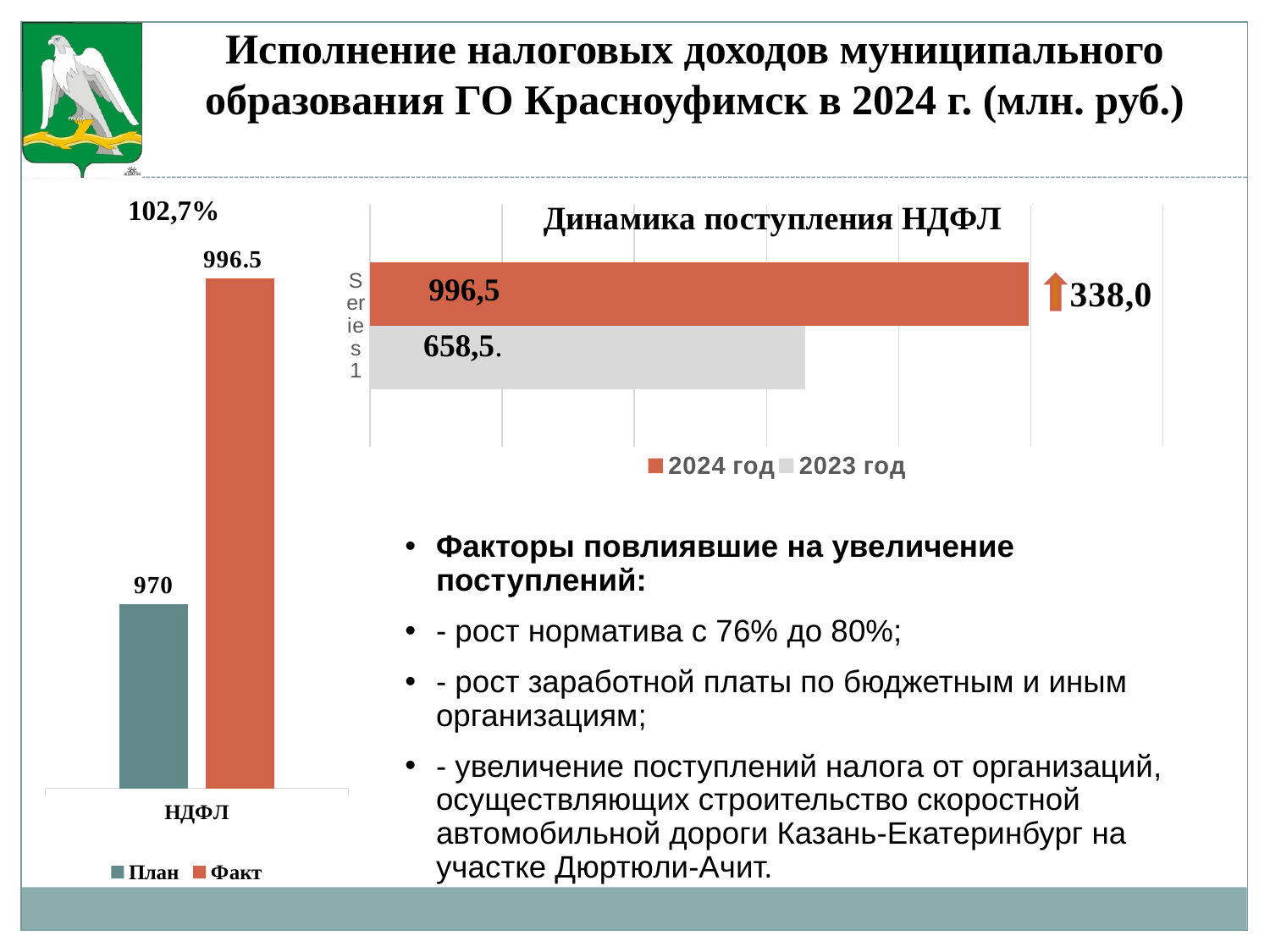
In the chart titled 'Динамика поступления НДФЛ', what is the difference between the 2024 год and 2023 год values? 338,0 In the left chart, what is the value of the План bar for НДФЛ? 970 In the chart titled 'Динамика поступления НДФЛ', which year has the higher value? 2024 год What is the title of the chart on the right side of the slide? Динамика поступления НДФЛ In the left chart, what is the value of the Факт bar for НДФЛ? 996.5 In the left chart, what is the difference between the Факт and План values for НДФЛ? 26.5 What kind of chart is the left chart? bar chart In the chart titled 'Динамика поступления НДФЛ', what is the value for 2023 год? 658,5 How many series does the legend of the chart titled 'Динамика поступления НДФЛ' list? 2 In the chart titled 'Динамика поступления НДФЛ', what is the value for 2024 год? 996,5 How many series does the legend of the left chart list? 2 In the left chart, which series is larger for НДФЛ, План or Факт? Факт